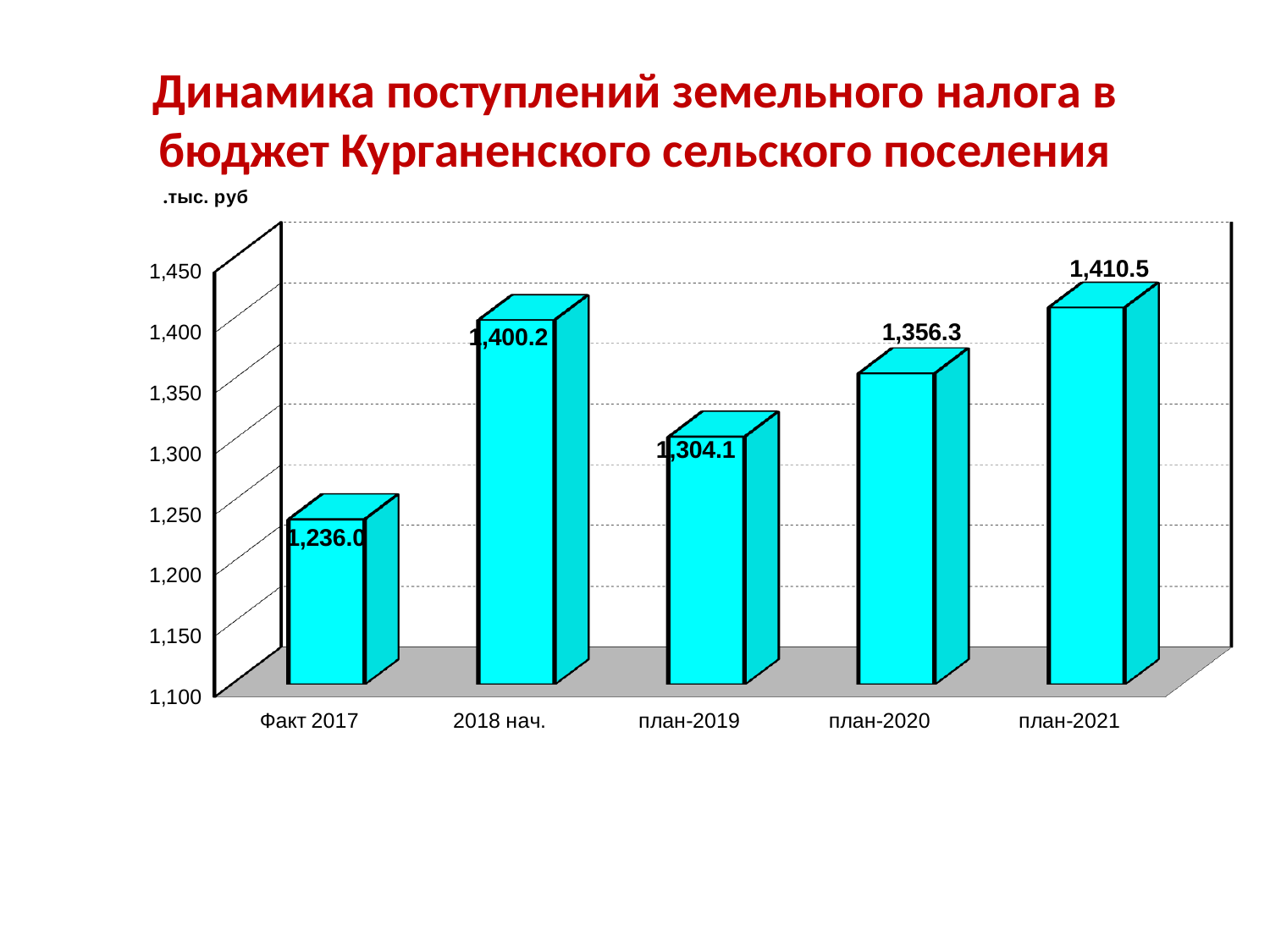
What is the difference between the values for план-2021 and Факт 2017? 174.5 What kind of chart is shown on the slide? bar chart Which category has the highest value? план-2021 What unit is indicated above the vertical axis? тыс. руб What is the value for план-2020? 1,356.3 Which is larger, the value for 2018 нач. or the value for план-2020? 2018 нач. What is the value for план-2021? 1,410.5 What is the value for Факт 2017? 1,236.0 How many categories are shown on the x axis? 5 Which category has the lowest value? Факт 2017 What is the value for 2018 нач.? 1,400.2 What is the value for план-2019? 1,304.1